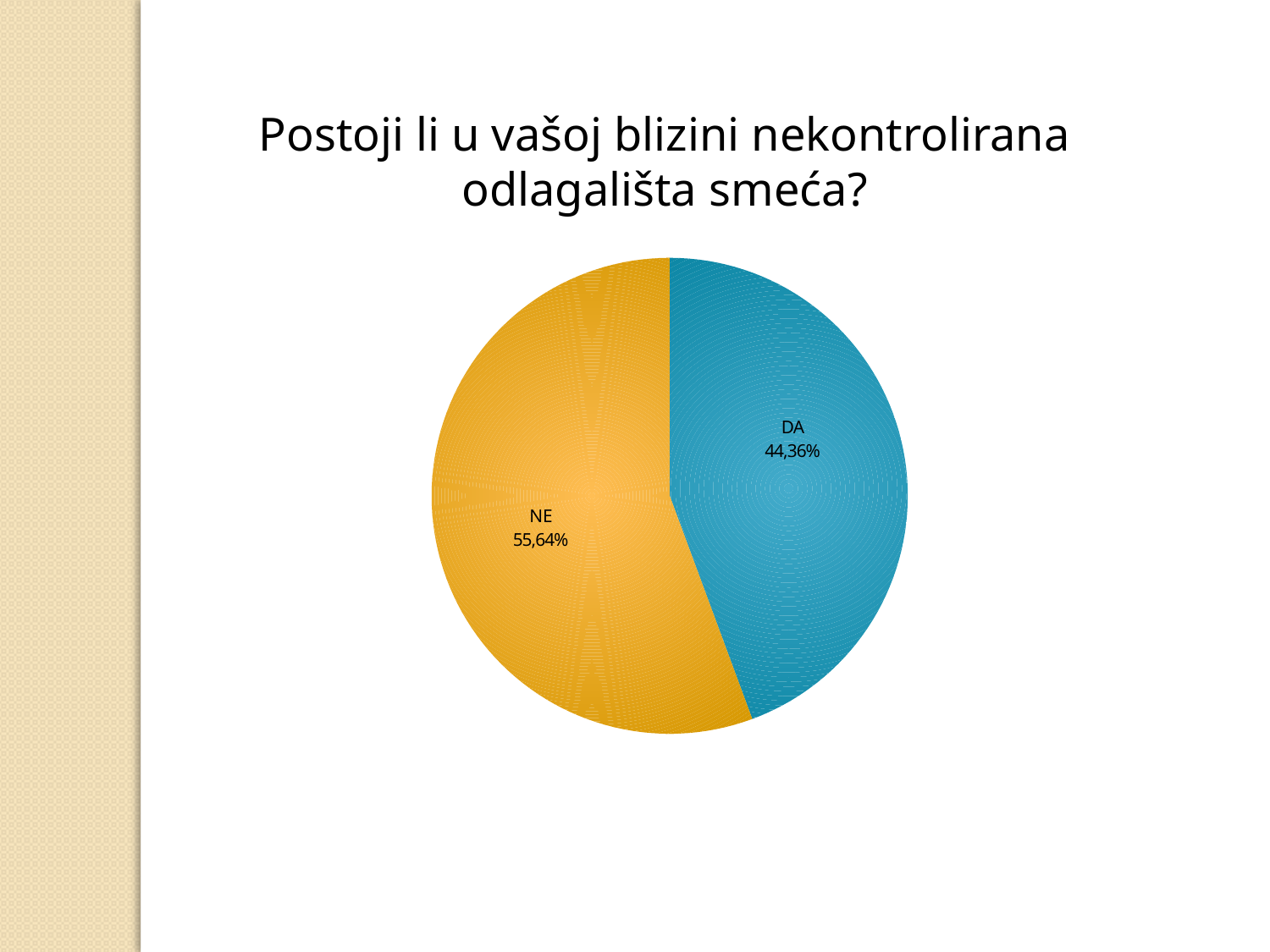
What type of chart is shown on the slide? pie chart Which category has the largest share of the pie? NE What is the title of the chart? Postoji li u vašoj blizini nekontrolirana odlagališta smeća? What share of the pie does the NE slice represent? 55,64% What is the value for NE? 55,64% What is the difference between the NE and DA shares? 11,28% What is the value for DA? 44,36% Which category has the smallest share of the pie? DA How many slices does the pie chart have? 2 What colour is the DA slice? blue Which is larger, DA or NE? NE